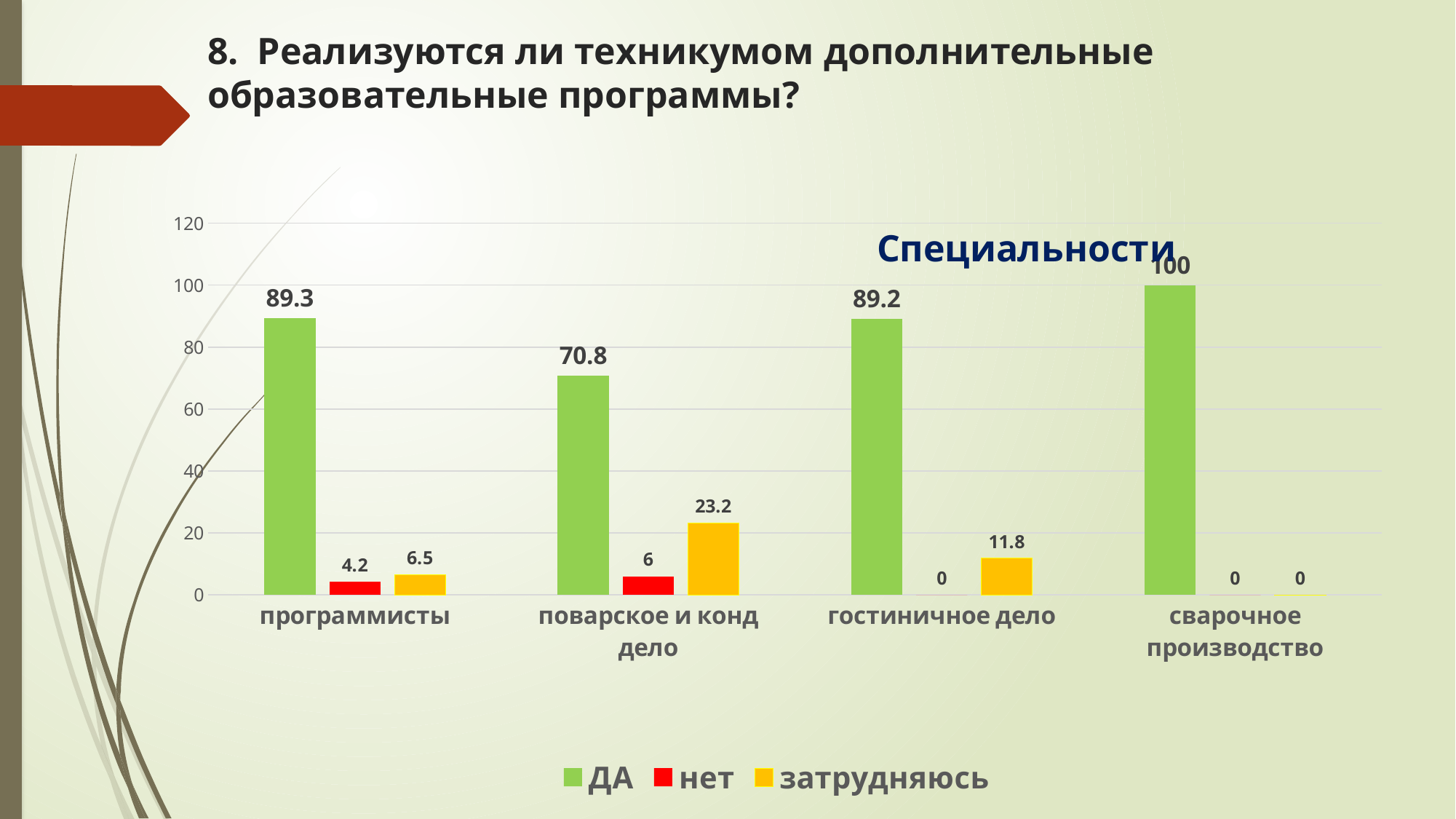
Which category has the lowest value in the ДА series? поварское и конд дело What is the value of the ДА series for программисты? 89.3 Which category has the highest value in the ДА series? сварочное производство Is the ДА value for поварское и конд дело greater or less than 80? less Which is larger: the затрудняюсь value for программисты or for гостиничное дело? гостиничное дело How many categories are shown on the x axis? 4 What is the difference between the ДА values for сварочное производство and поварское и конд дело? 29.2 What is the title of the chart? Специальности How many series does the legend list? 3 What is the value of the затрудняюсь series for поварское и конд дело? 23.2 What is the value of the нет series for гостиничное дело? 0 What kind of chart is shown on the slide? bar chart